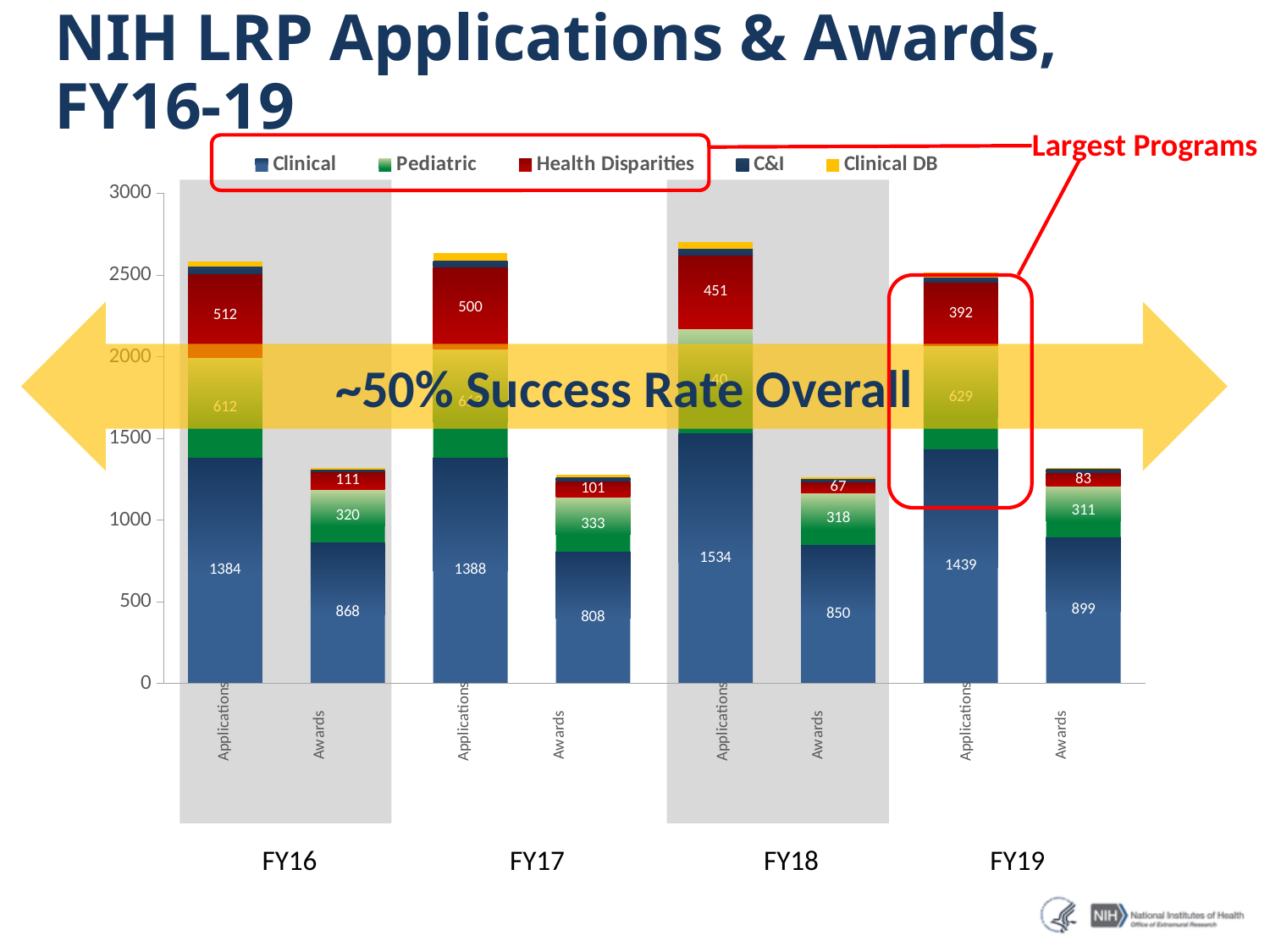
How many series does the legend list? 5 Which fiscal year has the lowest Health Disparities value among the Awards bars? FY18 How many bars are plotted in the chart? 8 Which fiscal year has the highest Clinical value among the Applications bars? FY18 What is the Clinical value for FY18 Applications? 1534 Do the Health Disparities values for Applications rise or fall from FY16 to FY19? fall What is the Health Disparities value for FY16 Awards? 111 What is the difference between the Clinical value for FY19 Awards and FY17 Awards? 91 What is the Pediatric value for FY19 Applications? 629 What is the difference between the Clinical value for FY19 Applications and FY16 Applications? 55 Which is larger, the Pediatric value for FY17 Awards or for FY16 Awards? FY17 Awards Is the total height of the FY18 Applications bar greater or less than 2500? greater